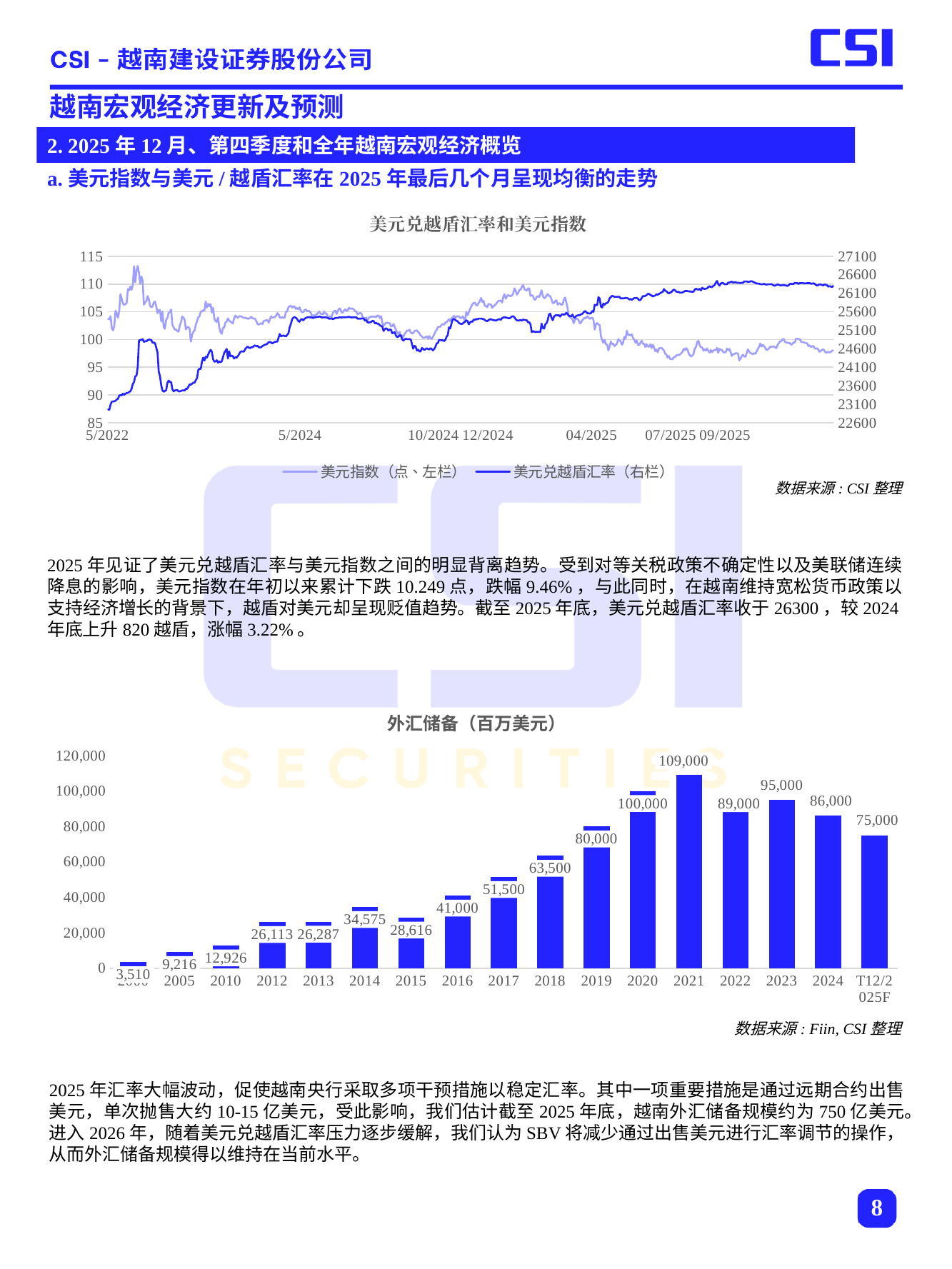
In the 外汇储备（百万美元） chart, what is the difference between the values for 2020 and 2019? 20,000 In the 外汇储备（百万美元） chart, what is the value for 2014? 34,575 In the 外汇储备（百万美元） chart, what is the value for T12/2025F? 75,000 In the 外汇储备（百万美元） chart, what is the value for 2021? 109,000 In the 外汇储备（百万美元） chart, which year has the highest value? 2021 In the 外汇储备（百万美元） chart, which is larger, the value for 2022 or the value for 2023? 2023 In the 外汇储备（百万美元） chart, how many bars are plotted? 17 In the 外汇储备（百万美元） chart, what is the difference between the values for 2023 and 2024? 9,000 How many series does the legend of the 美元兑越盾汇率和美元指数 chart list? 2 What kind of chart is the 美元兑越盾汇率和美元指数 chart? Line chart In the 外汇储备（百万美元） chart, do the values rise or fall from 2016 to 2021? Rise What kind of chart is the 外汇储备（百万美元） chart? Bar chart